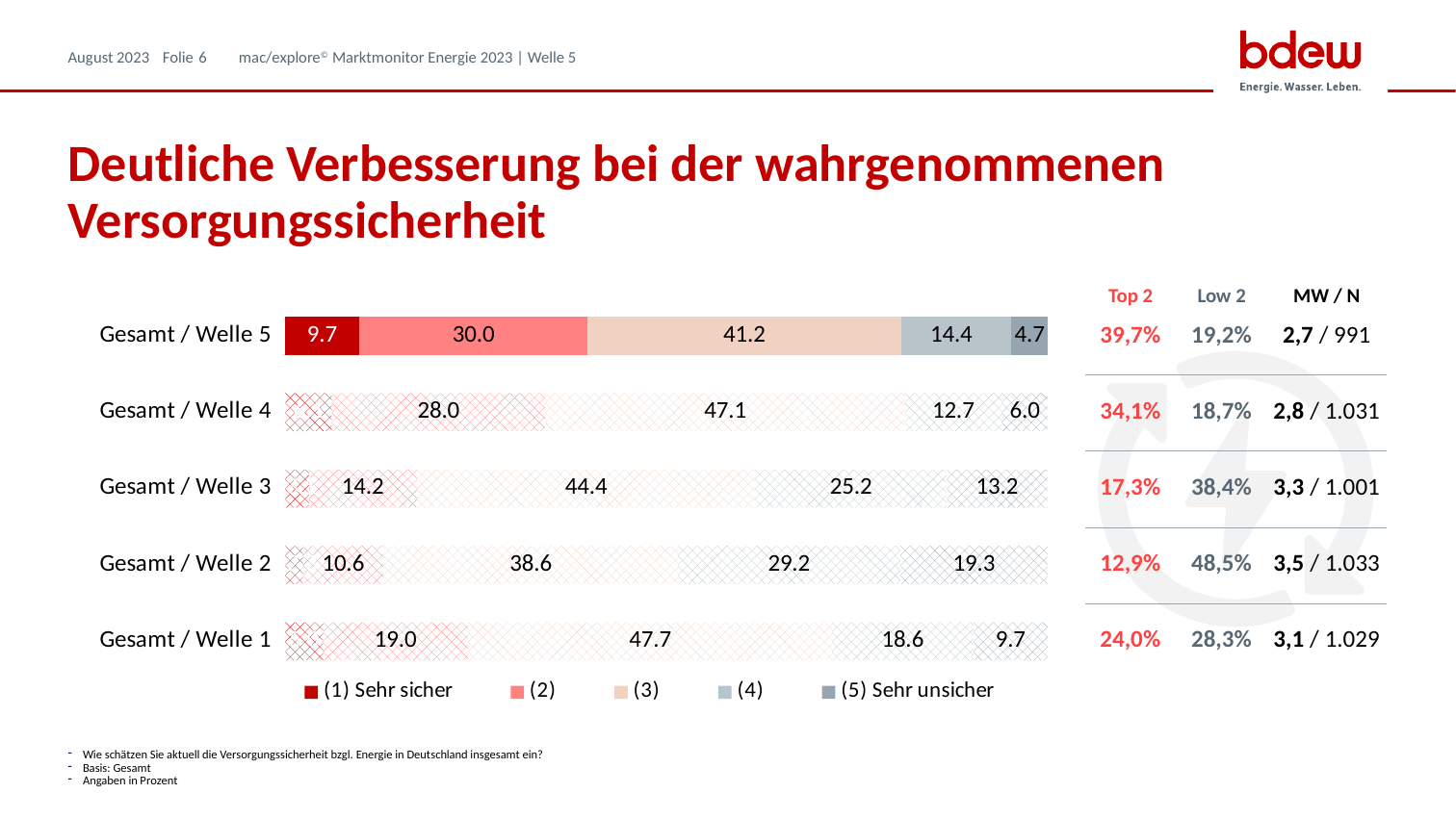
What is the value of the "(5) Sehr unsicher" segment for Gesamt / Welle 3? 13.2 Which segment is the largest in the Gesamt / Welle 5 bar? (3) What is the difference between the "(2)" and "(5) Sehr unsicher" values for Gesamt / Welle 5? 25.3 What kind of chart is shown on the slide? Stacked bar chart What is the total of the Gesamt / Welle 5 stacked bar? 100.0 Which has the larger "(3)" value, Gesamt / Welle 3 or Gesamt / Welle 2? Gesamt / Welle 3 What is the value of the "(3)" segment for Gesamt / Welle 5? 41.2 How many series does the legend list? 5 How many bars (categories) are shown in the chart? 5 What is the value of the "(4)" segment for Gesamt / Welle 4? 12.7 Which segment is the smallest in the Gesamt / Welle 5 bar? (5) Sehr unsicher What is the value of the "(2)" segment for Gesamt / Welle 1? 19.0